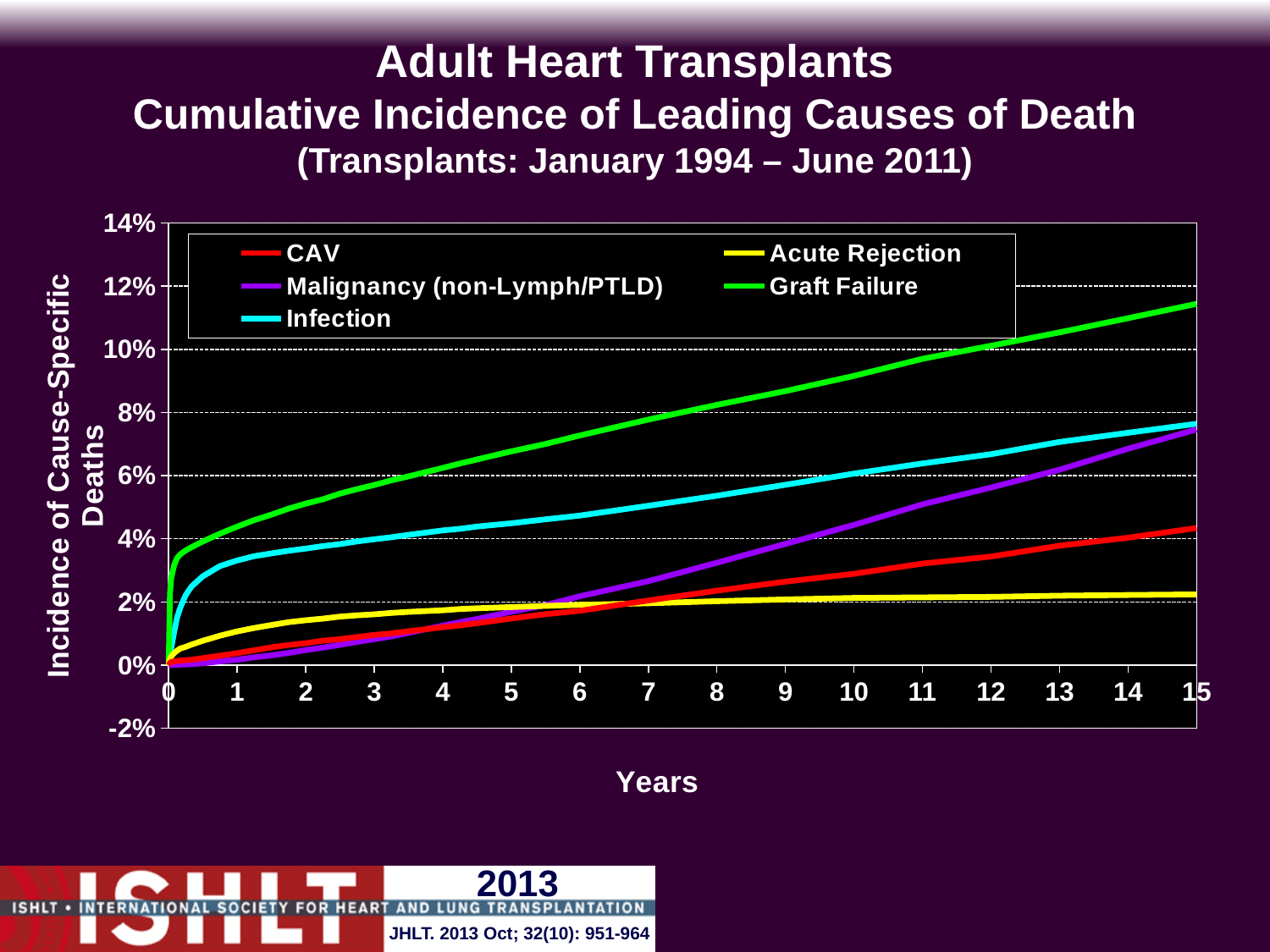
Is the value for Malignancy (non-Lymph/PTLD) at 5 years greater or less than 2%? less Which cause of death has the lowest cumulative incidence at 15 years? Acute Rejection Is the value for Graft Failure at 10 years greater or less than 8%? greater How many series does the legend list? 5 Is the value for Acute Rejection at 15 years greater or less than 4%? less Does the Graft Failure line rise or fall as years increase? rise At 10 years, which is larger: the value for Graft Failure or the value for CAV? Graft Failure At 12 years, which is larger: the value for Malignancy (non-Lymph/PTLD) or the value for Acute Rejection? Malignancy (non-Lymph/PTLD) Which cause of death has the highest cumulative incidence at 15 years? Graft Failure What kind of chart is shown on the slide? line chart